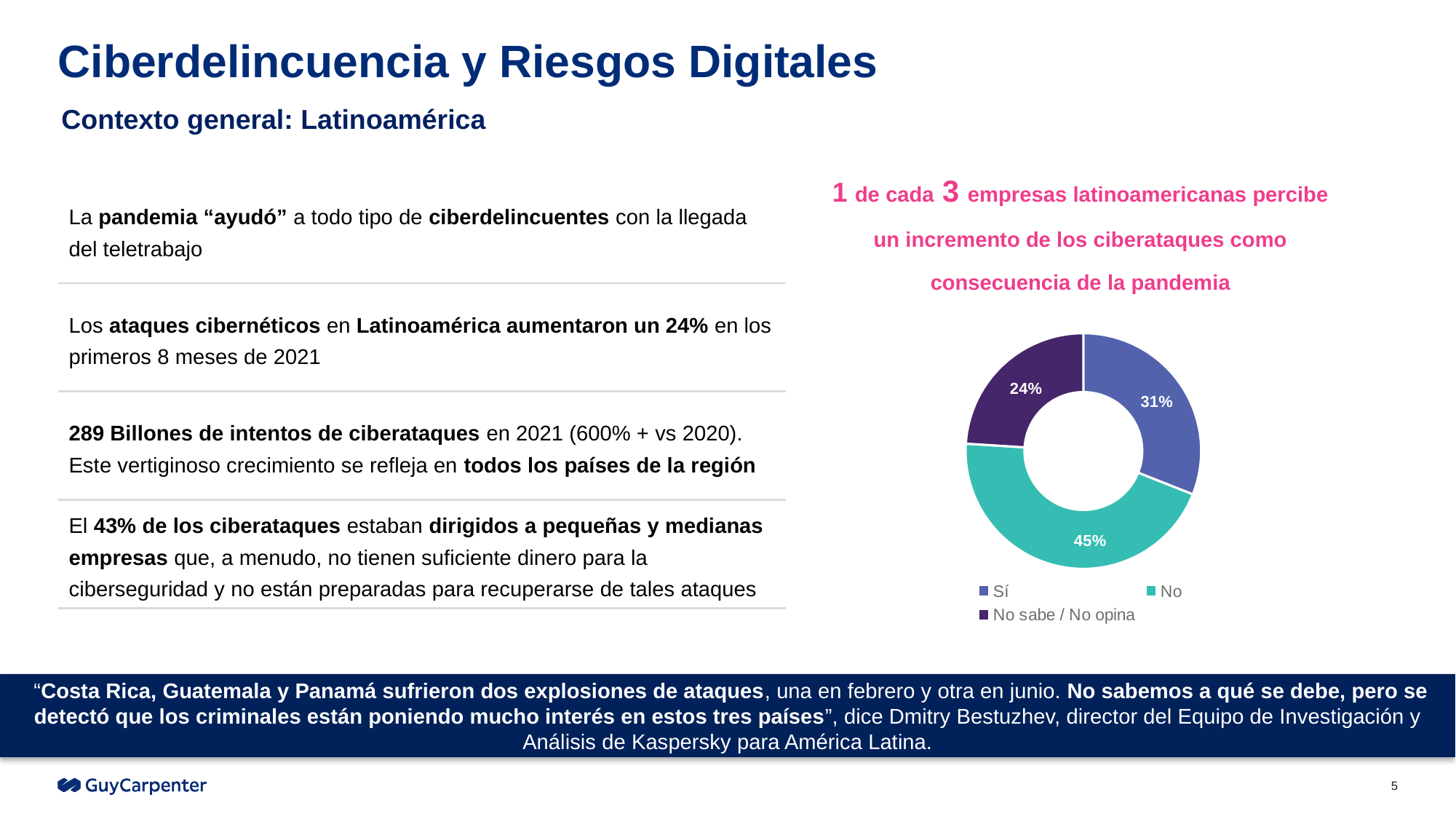
Which category has the largest share of the chart? No Which slice is larger, "Sí" or "No sabe / No opina"? Sí What type of chart is shown on the slide? Pie chart (doughnut) What percentage of the chart corresponds to "No sabe / No opina"? 24% What colour is the "No" slice in the chart? Teal How many categories does the chart show? 3 What is the combined share of the "Sí" and "No" slices? 76% How many entries does the chart legend list? 3 Which category has the smallest share of the chart? No sabe / No opina What percentage of the chart corresponds to "No"? 45% What percentage of the chart corresponds to "Sí"? 31% What is the difference in percentage points between the "No" and "Sí" slices? 14